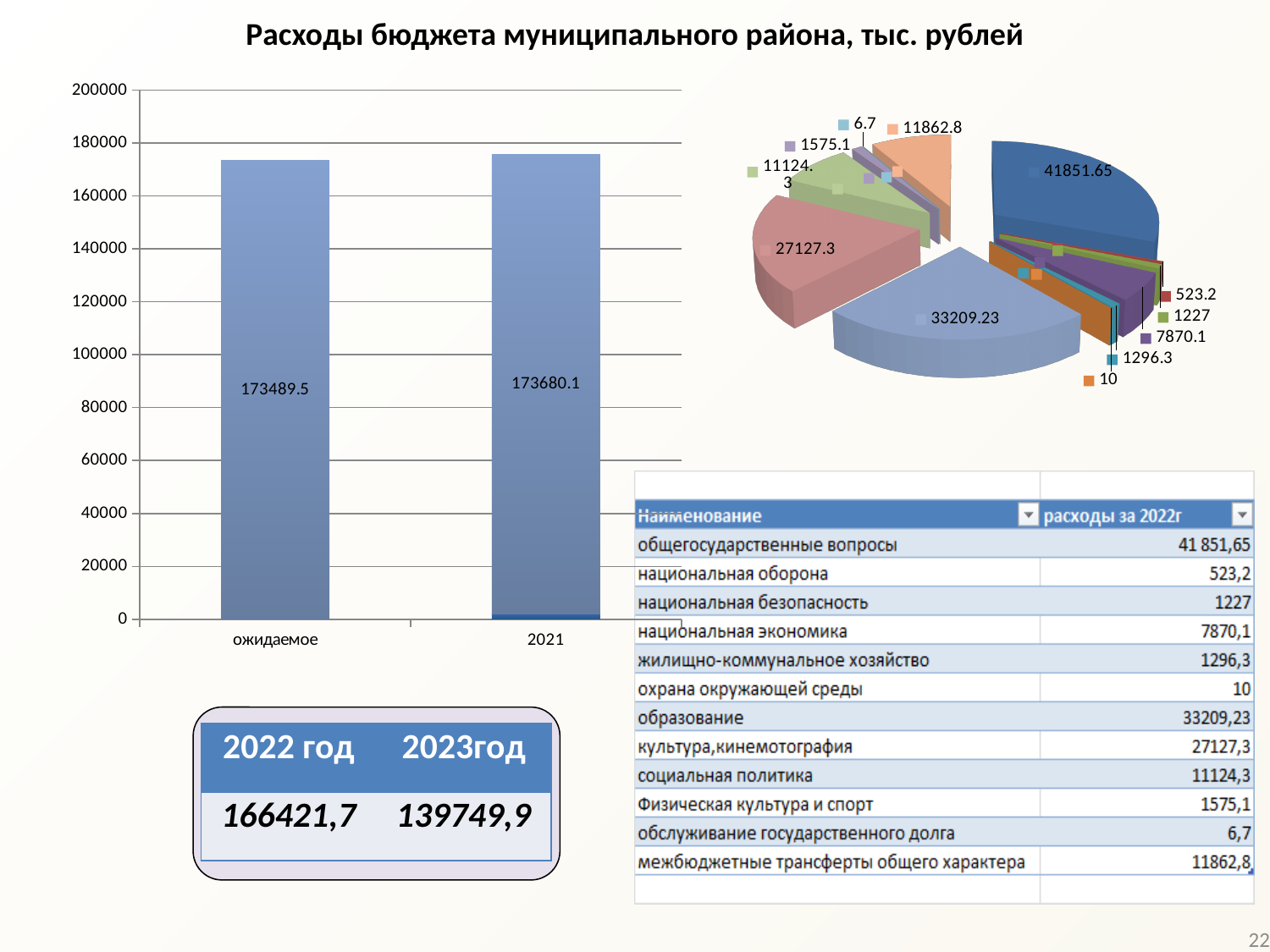
On the bar chart on the left, what is the value for 'ожидаемое'? 173489.5 What is the title shown at the top of the slide above the charts? Расходы бюджета муниципального района, тыс. рублей On the bar chart on the left, what is the difference between the value for '2021' and the value for 'ожидаемое'? 190.6 On the bar chart on the left, is the value for '2021' greater or less than 180000? less On the pie chart on the upper right, what is the value of the smallest slice? 6.7 What kind of chart is the chart on the upper right of the slide? pie chart On the bar chart on the left, which category has the higher value, 'ожидаемое' or '2021'? 2021 On the bar chart on the left, what is the value for '2021'? 173680.1 What kind of chart is the chart on the left of the slide? bar chart How many bars are shown on the bar chart on the left? 2 On the bar chart on the left, is the value for 'ожидаемое' greater or less than 160000? greater On the pie chart on the upper right, what is the value of the largest slice? 41851.65